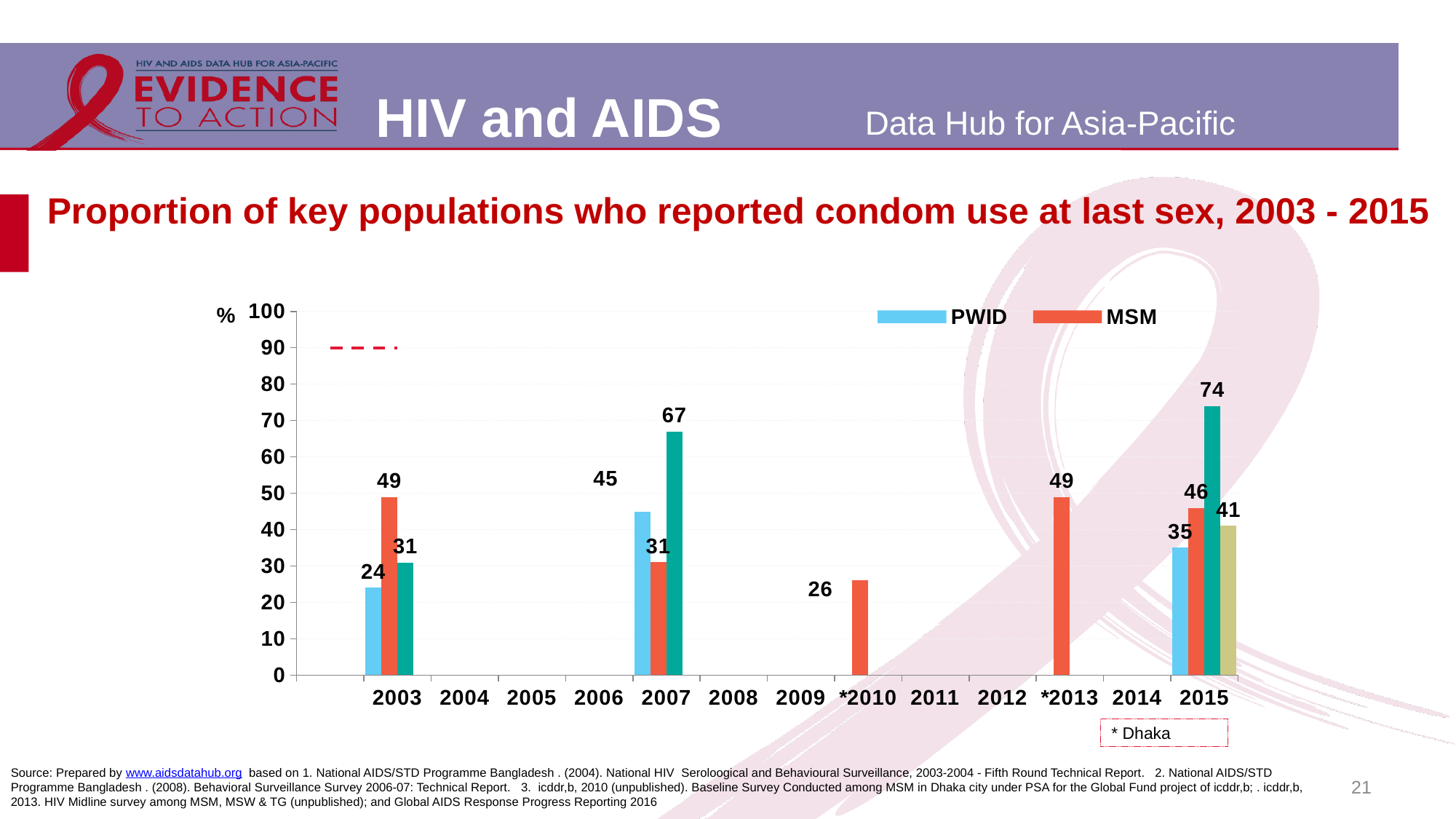
What is the difference between the MSM values in 2003 and 2007? 18 What is the value for MSM in *2010? 26 What is the value for MSM in 2015? 46 In which year is the MSM value lowest? *2010 In 2015, which is larger, the PWID value or the MSM value? MSM What is the value for PWID in 2003? 24 How many series does the legend list? 2 Did the PWID value rise or fall from 2003 to 2007? rise What kind of chart is shown on the slide? bar chart What is the value for MSM in 2003? 49 What is the value for PWID in 2007? 45 At what level on the y axis is the red dashed line drawn? 90